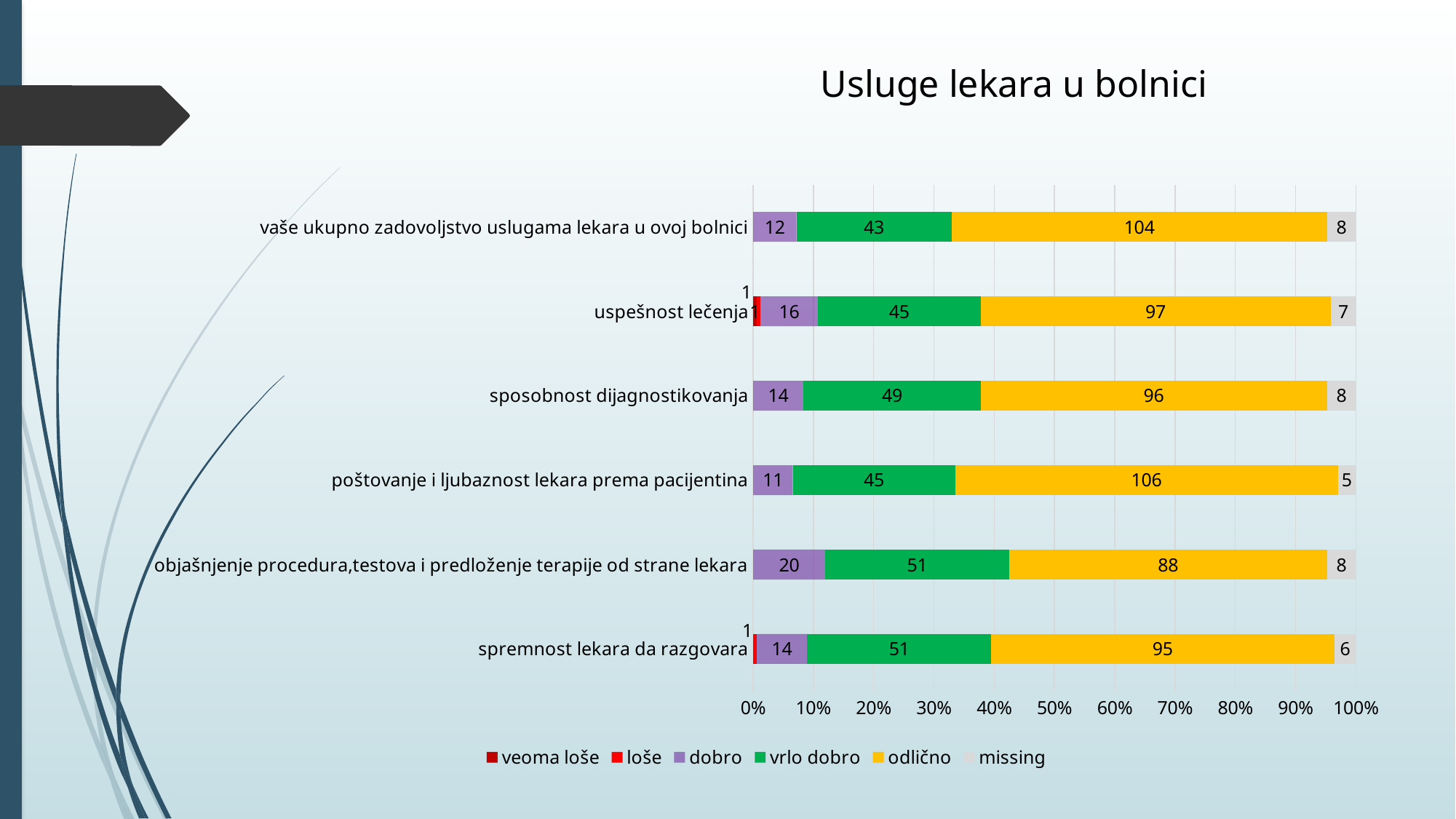
What is the value of the 'dobro' segment for 'objašnjenje procedura,testova i predloženje terapije od strane lekara'? 20 What is the title of the chart? Usluge lekara u bolnici What is the 'missing' value for 'uspešnost lečenja'? 7 What is the difference between the 'odlično' values for 'vaše ukupno zadovoljstvo uslugama lekara u ovoj bolnici' and 'uspešnost lečenja'? 7 What kind of chart is shown on the slide? Stacked bar chart Which has the larger 'vrlo dobro' value: 'sposobnost dijagnostikovanja' or 'spremnost lekara da razgovara'? spremnost lekara da razgovara Which category has the highest 'odlično' value? poštovanje i ljubaznost lekara prema pacijentina How many categories are shown on the chart? 6 How many series does the legend list? 6 Which category has the lowest 'odlično' value? objašnjenje procedura,testova i predloženje terapije od strane lekara What is the total of all labelled segments for 'vaše ukupno zadovoljstvo uslugama lekara u ovoj bolnici'? 167 What is the value of the 'odlično' segment for 'poštovanje i ljubaznost lekara prema pacijentina'? 106